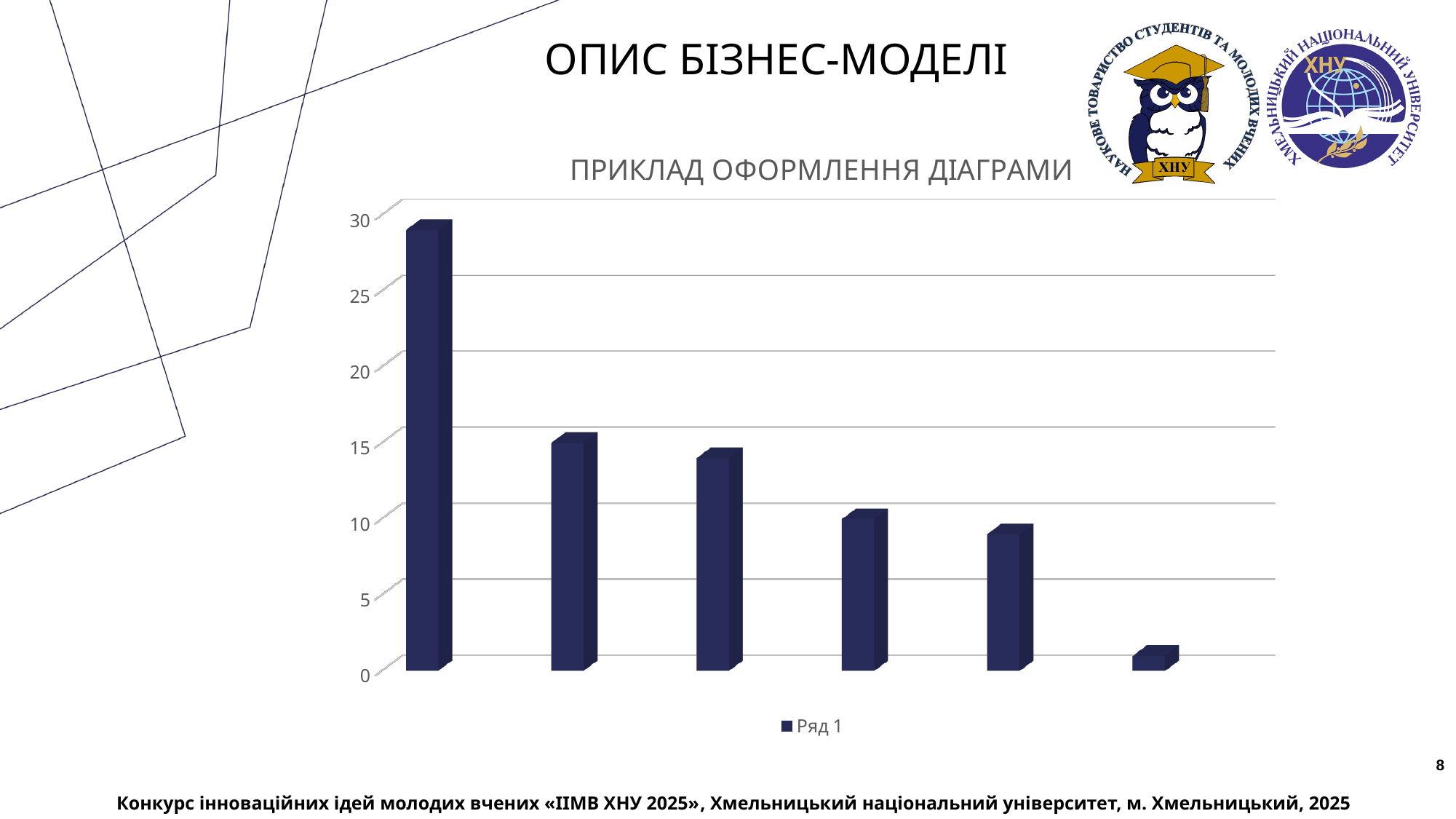
What is the title of the chart? ПРИКЛАД ОФОРМЛЕННЯ ДІАГРАМИ Is the value of the second bar greater or less than 10? greater What kind of chart is shown on the slide? bar chart Is the value of the first (leftmost) bar greater or less than 25? greater Which bar is the lowest in the chart? the last (rightmost) bar How many bars does the chart contain? 6 What is the name of the series shown in the legend? Ряд 1 How many series does the legend list? 1 Is the value of the last (rightmost) bar greater or less than 5? less Which bar is the highest in the chart? the first (leftmost) bar Do the bar values rise or fall from left to right along the x axis? fall Which is larger, the first bar or the second bar? the first bar